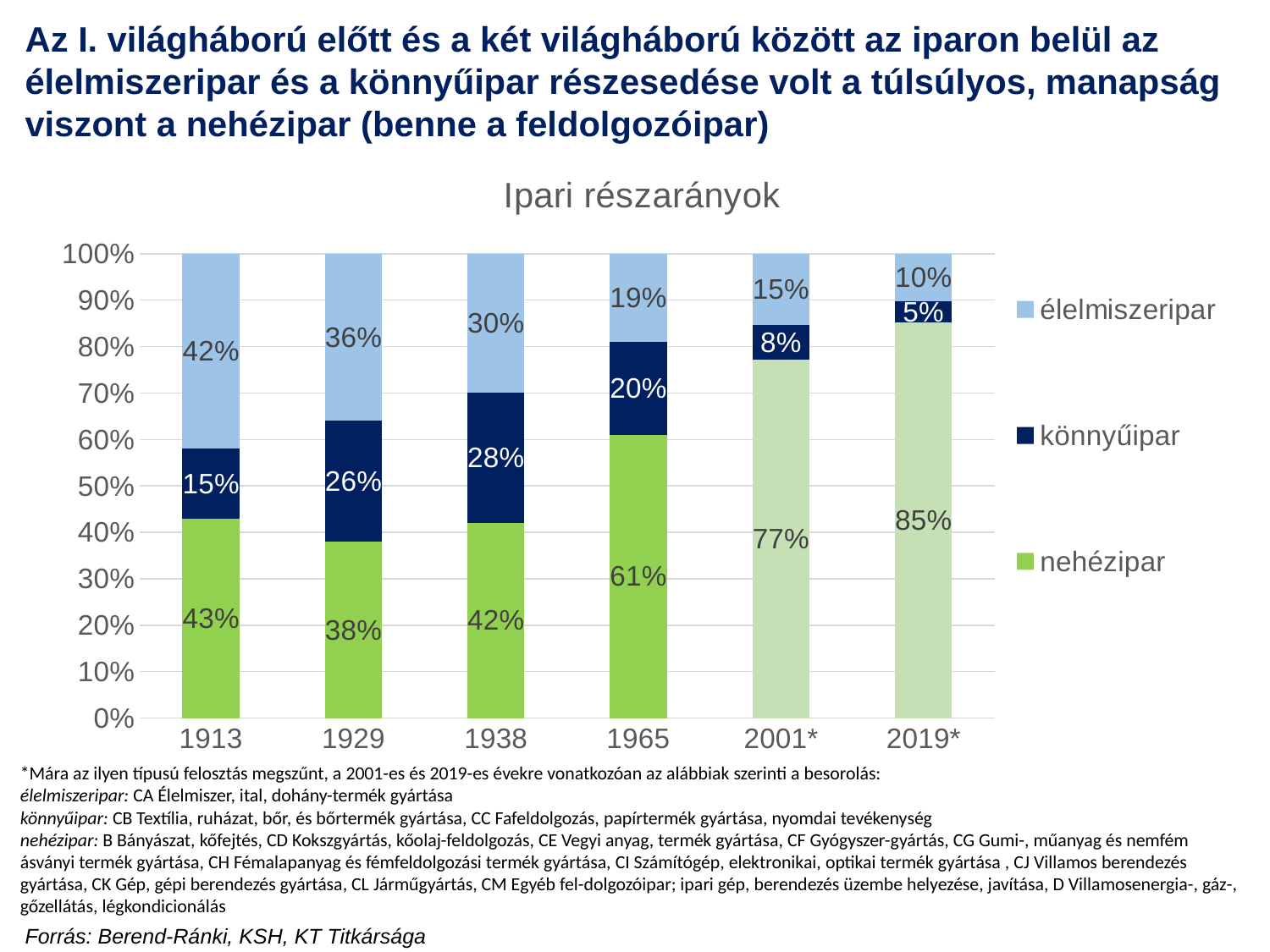
How many years (categories) are shown on the x axis? 6 What is the title of the chart? Ipari részarányok In which year is the share of nehézipar the highest? 2019* Does the share of nehézipar rise or fall from 1938 to 2019*? rise In which year is the share of élelmiszeripar the lowest? 2019* How many series does the legend list? 3 What type of chart is shown on the slide? stacked bar chart Which is larger in 1929: the share of könnyűipar or the share of élelmiszeripar? élelmiszeripar What is the share of könnyűipar in 2019*? 5% What is the share of nehézipar in 1965? 61% What is the share of élelmiszeripar in 1913? 42% What is the difference between the nehézipar share in 2001* and in 1938? 35 percentage points